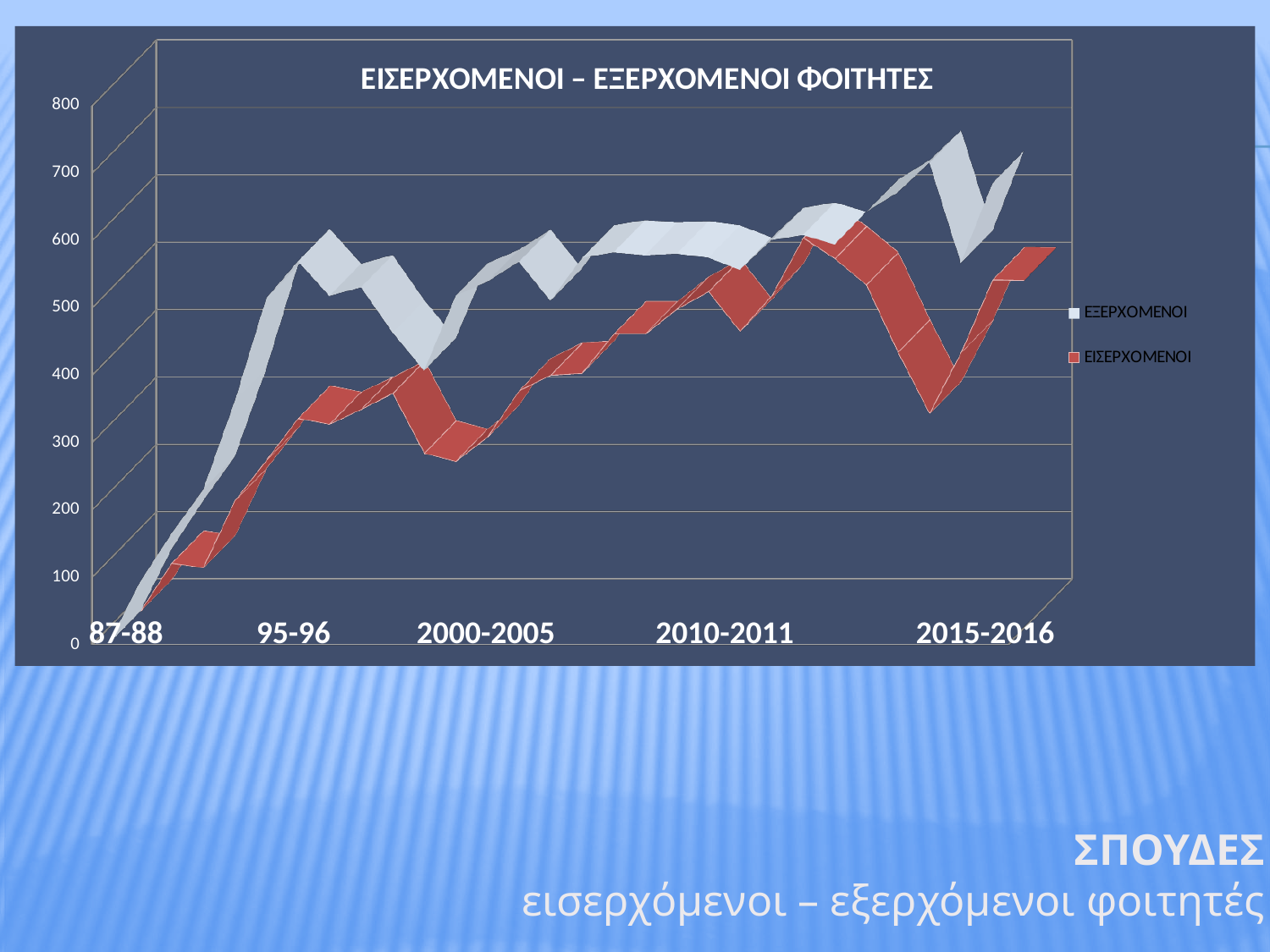
Is the value for ΕΙΣΕΡΧΟΜΕΝΟΙ at 87-88 greater or less than 100? less What is the title of the chart? ΕΙΣΕΡΧΟΜΕΝΟΙ – ΕΞΕΡΧΟΜΕΝΟΙ ΦΟΙΤΗΤΕΣ Is the value for ΕΙΣΕΡΧΟΜΕΝΟΙ at 2000-2005 greater or less than 400? less Is the value for ΕΞΕΡΧΟΜΕΝΟΙ at 95-96 greater or less than 400? greater Overall, do the values for ΕΞΕΡΧΟΜΕΝΟΙ rise or fall from 87-88 to 2015-2016? rise At 95-96, which series has the higher value, ΕΙΣΕΡΧΟΜΕΝΟΙ or ΕΞΕΡΧΟΜΕΝΟΙ? ΕΞΕΡΧΟΜΕΝΟΙ What kind of chart is shown on the slide? line chart At 2000-2005, which series has the higher value, ΕΙΣΕΡΧΟΜΕΝΟΙ or ΕΞΕΡΧΟΜΕΝΟΙ? ΕΞΕΡΧΟΜΕΝΟΙ Which series is drawn in red? ΕΙΣΕΡΧΟΜΕΝΟΙ How many series does the chart legend list? 2